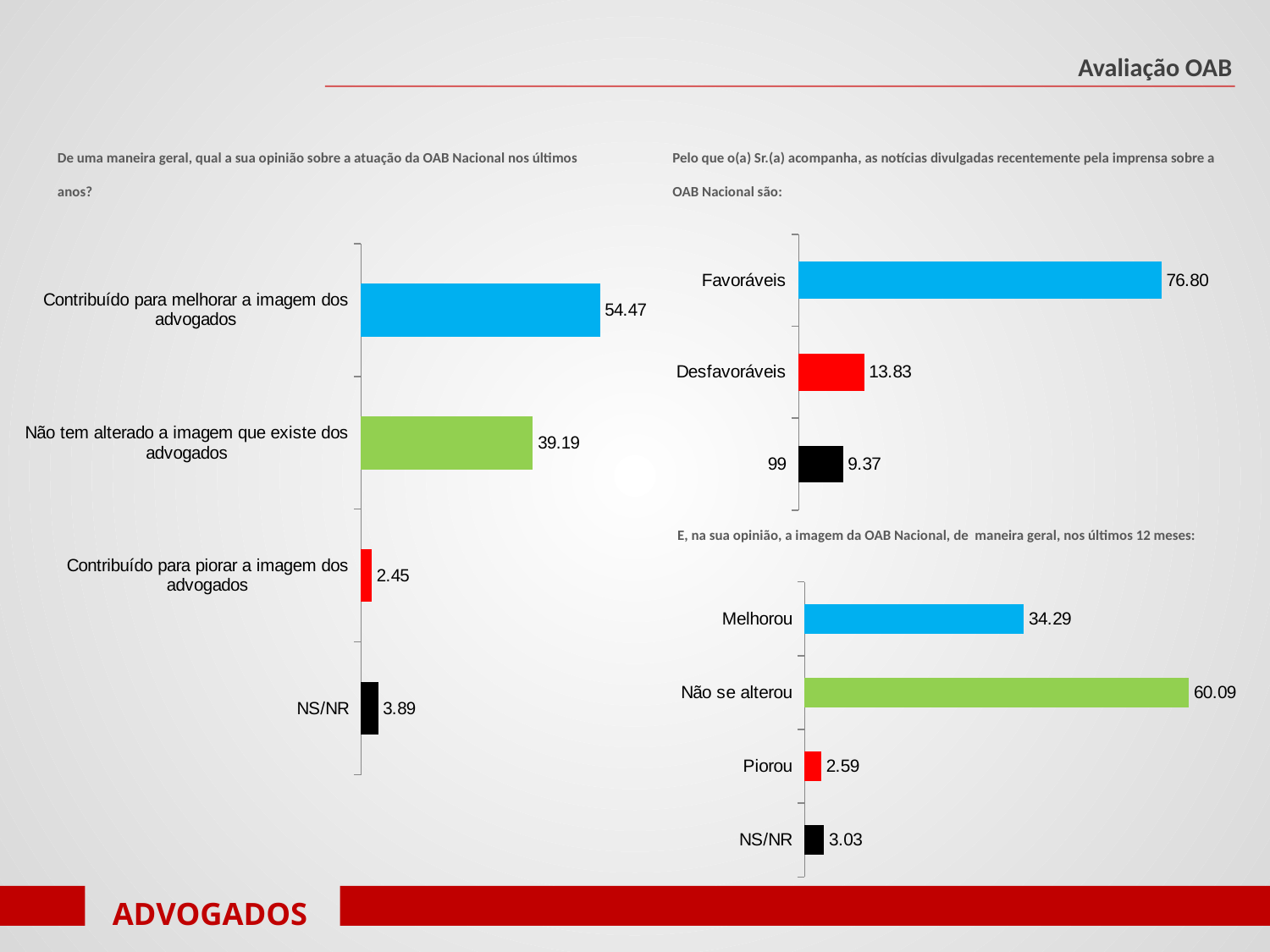
In the bottom-right chart about the image of the OAB Nacional in the last 12 months, what is the value for "Não se alterou"? 60.09 In the left chart about the opinion on the OAB Nacional's performance, which category has the lowest value? Contribuído para piorar a imagem dos advogados In the bottom-right chart about the image of the OAB Nacional in the last 12 months, what is the value for "NS/NR"? 3.03 In the top-right chart about recent press news on the OAB Nacional, what is the value for "Favoráveis"? 76.80 In the left chart about the opinion on the OAB Nacional's performance in recent years, what is the value for "Contribuído para melhorar a imagem dos advogados"? 54.47 What kind of chart is the bottom-right chart about the image of the OAB Nacional in the last 12 months? Bar chart In the bottom-right chart about the image of the OAB Nacional in the last 12 months, which is larger, "Melhorou" or "Piorou"? Melhorou In the left chart about the opinion on the OAB Nacional's performance, what is the difference between "Contribuído para melhorar a imagem dos advogados" and "Não tem alterado a imagem que existe dos advogados"? 15.28 In the left chart about the opinion on the OAB Nacional's performance, how many categories are shown? 4 In the top-right chart about recent press news on the OAB Nacional, what is the difference between "Desfavoráveis" and the category labelled "99"? 4.46 In the top-right chart about recent press news on the OAB Nacional, which category has the highest value? Favoráveis In the left chart about the opinion on the OAB Nacional's performance, what colour is the bar for "Não tem alterado a imagem que existe dos advogados"? Green